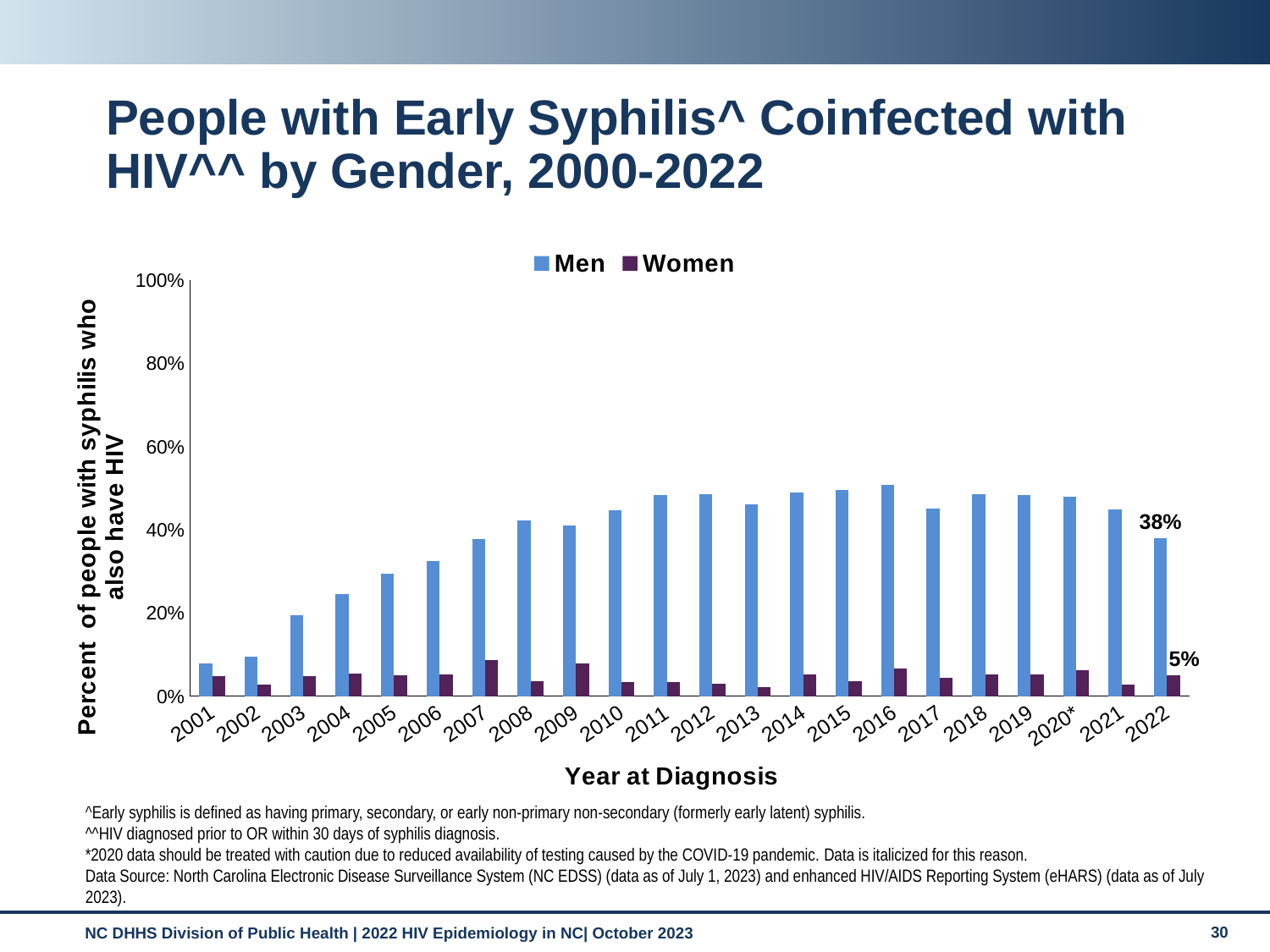
In which year is the Men value lowest? 2001 Do the Men values rise or fall from 2001 to 2011? Rise What is the value for Women in 2022? 5% What kind of chart is shown on the slide? Bar chart Is the value for Men in 2016 greater or less than 40%? greater What is the value for Men in 2022? 38% In 2022, which series has the larger value, Men or Women? Men How many years are shown on the x axis? 22 What is the difference between the Men and Women values in 2022? 33 percentage points Is the value for Women in 2007 greater or less than 20%? less Is the value for Men in 2001 greater or less than 20%? less How many series does the legend list? 2